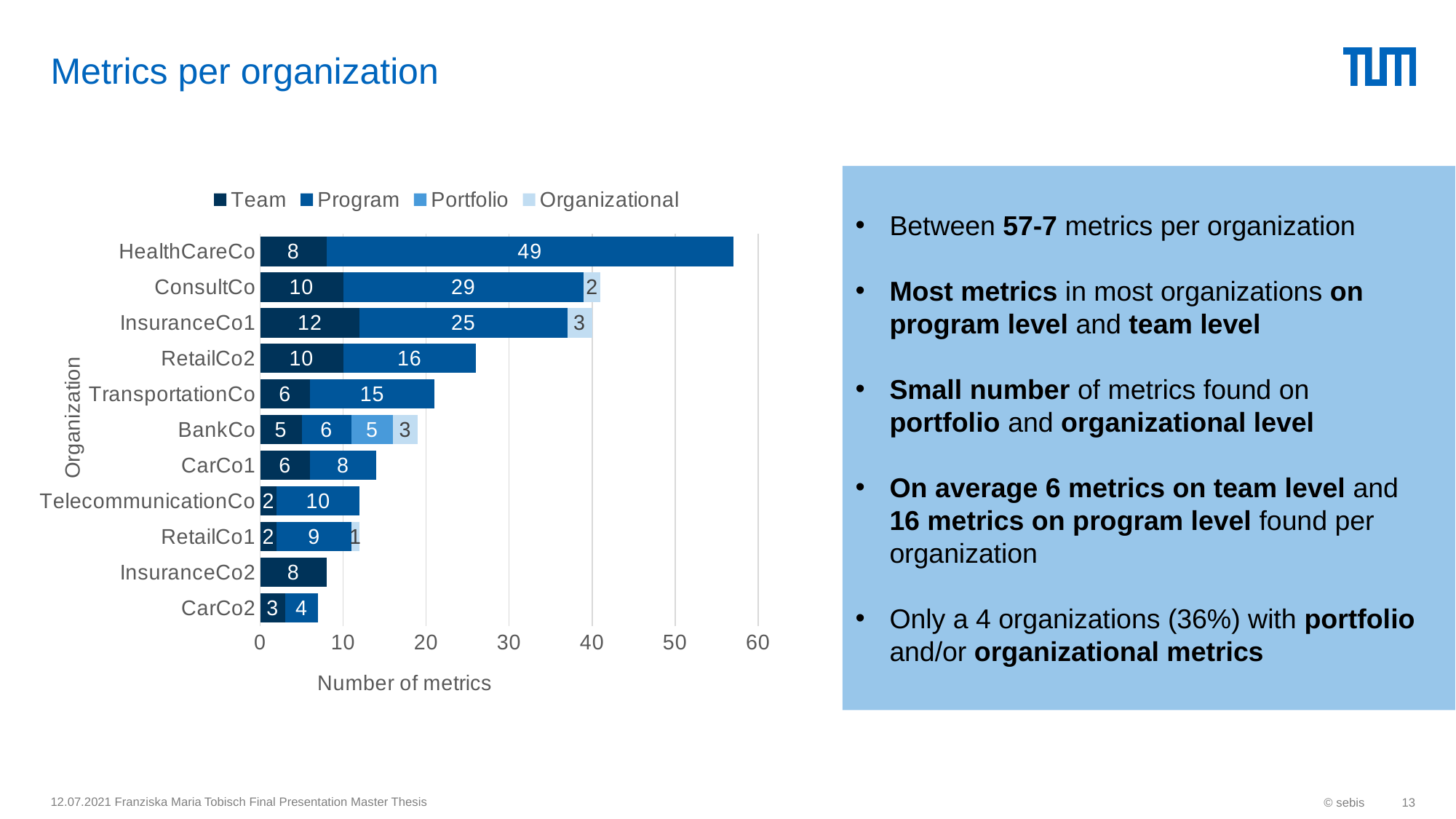
How many organizations are shown on the chart? 11 What is the total number of metrics for BankCo? 19 What is the Team value for InsuranceCo1? 12 What is the difference between the Program values of ConsultCo and InsuranceCo1? 4 Which is larger, the Team value for RetailCo2 or the Team value for TransportationCo? RetailCo2 Which organization has the highest total number of metrics? HealthCareCo What is the Portfolio value for BankCo? 5 How many series does the legend list? 4 What is the Program value for HealthCareCo? 49 Which organization has the lowest total number of metrics? CarCo2 What is the total number of metrics for HealthCareCo? 57 What type of chart is shown on the slide? Stacked bar chart